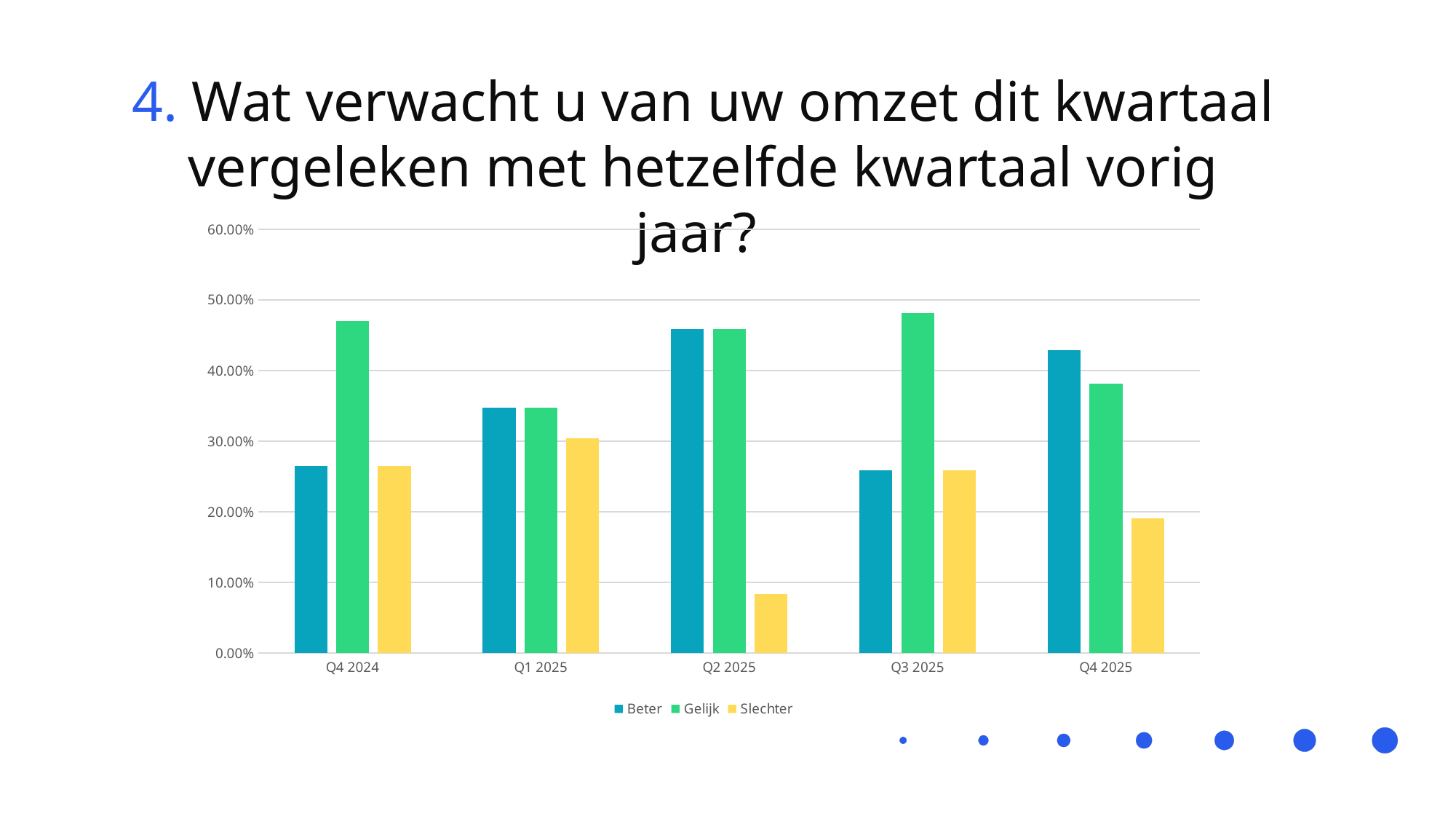
Does the Slechter value rise or fall from Q1 2025 to Q2 2025? fall Is the value for Beter in Q4 2024 greater or less than 30.00%? less Is the value for Gelijk in Q3 2025 greater or less than 40.00%? greater In which quarter is the Slechter value lowest? Q2 2025 What kind of chart is shown on the slide? bar chart Which is larger: Slechter in Q1 2025 or Slechter in Q2 2025? Q1 2025 Is the value for Slechter in Q2 2025 greater or less than 10.00%? less Which colour represents the Slechter series in the legend? yellow How many series does the legend list? 3 In Q4 2025, which is larger: Beter or Gelijk? Beter How many quarters are shown on the x axis? 5 In which quarter is the Beter value highest? Q2 2025